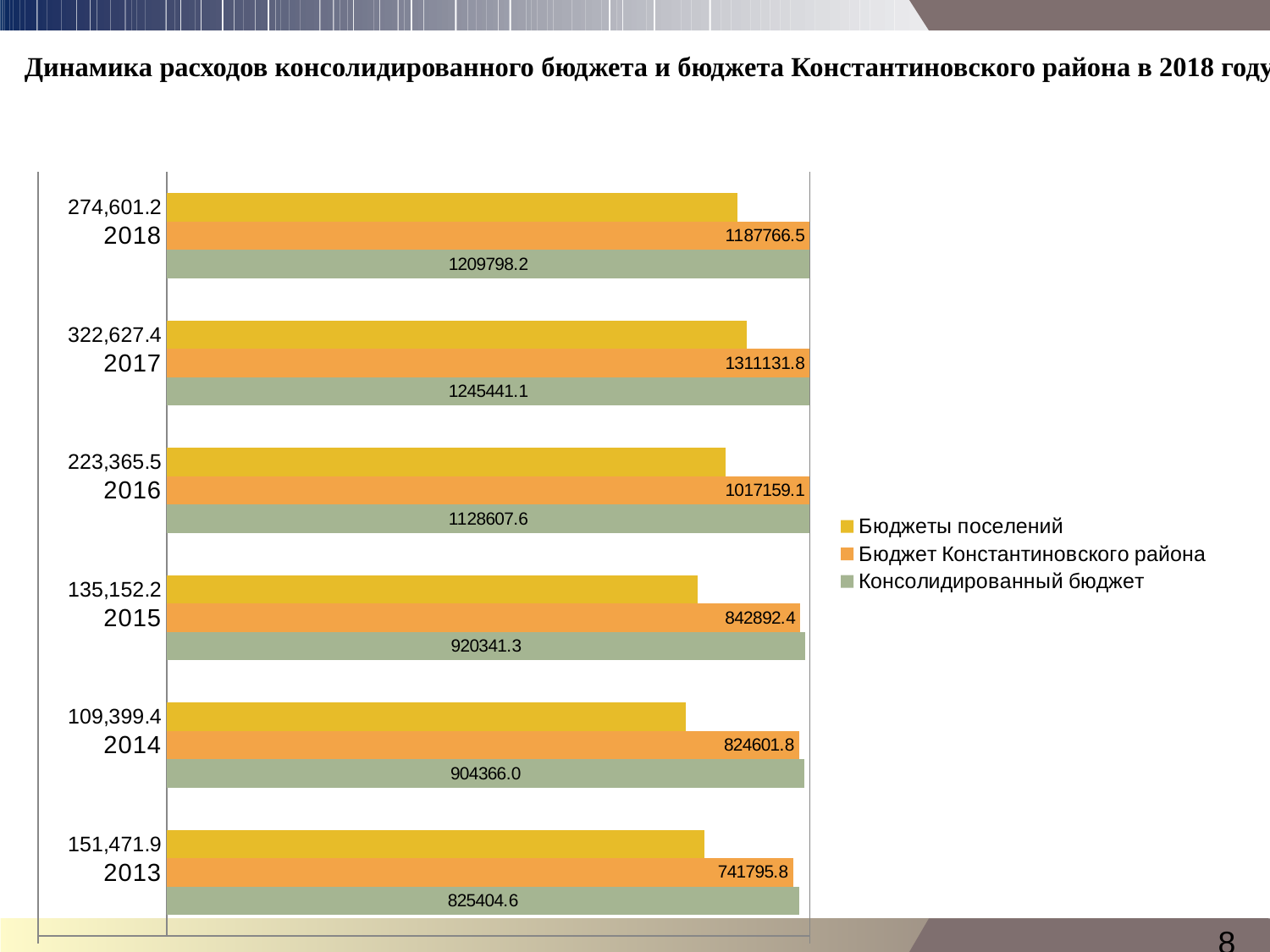
Does the Консолидированный бюджет value rise or fall from 2013 to 2016? rise What is the value of Бюджеты поселений for 2016? 223,365.5 How many series does the legend list? 3 What kind of chart is shown on the slide? bar chart What is the value of Консолидированный бюджет for 2018? 1209798.2 In which year is the Бюджет Константиновского района value the lowest? 2013 What colour represents Бюджеты поселений in the chart? yellow What is the difference between Консолидированный бюджет and Бюджет Константиновского района in 2014? 79764.2 How many years are shown on the chart? 6 What is the value of Бюджет Константиновского района for 2017? 1311131.8 In which year is the Консолидированный бюджет value the highest? 2017 In 2017, which is larger: Бюджет Константиновского района or Консолидированный бюджет? Бюджет Константиновского района